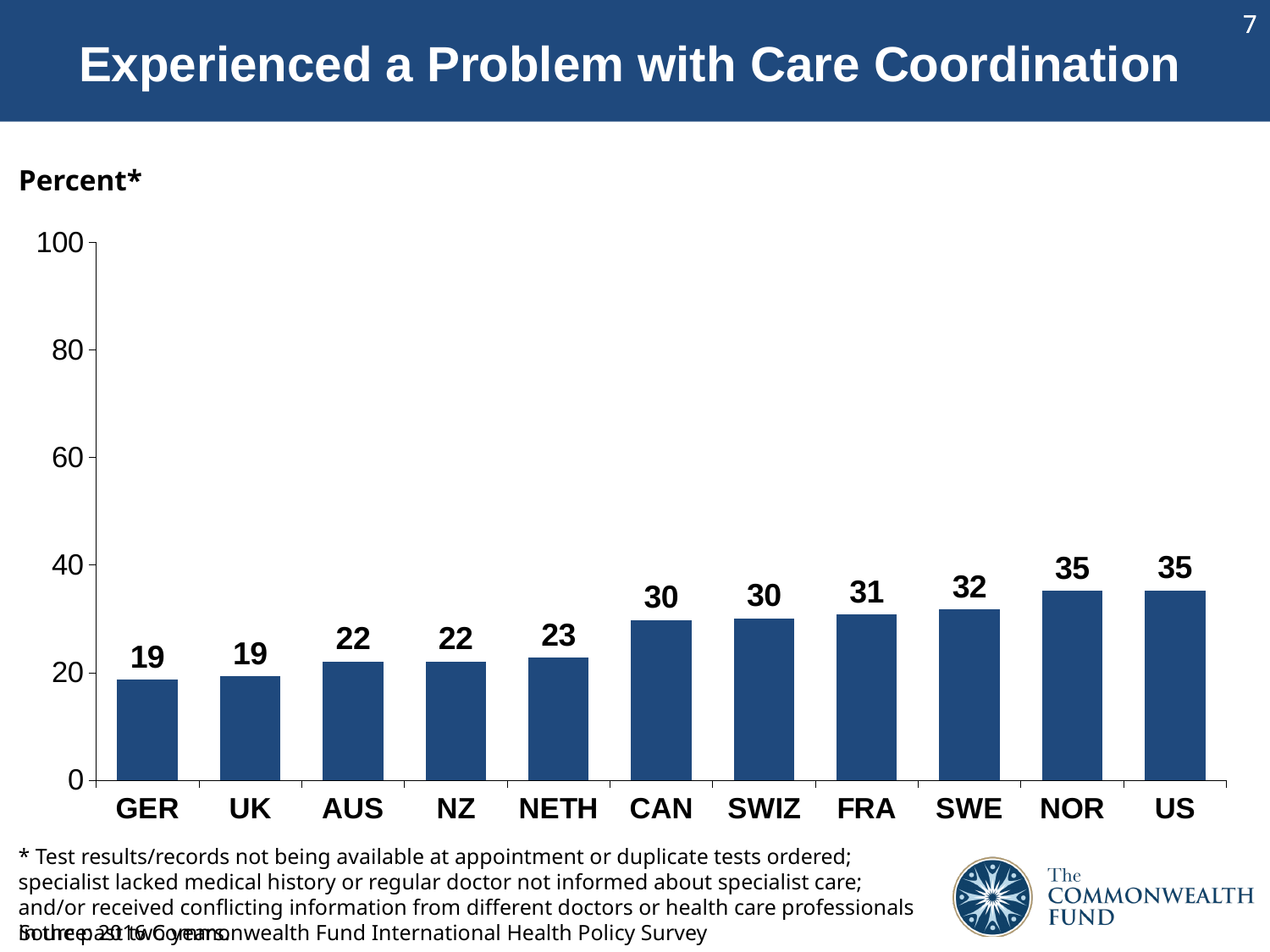
Do the values generally rise or fall from left to right along the x axis? rise What is the value for SWE? 32 Which countries have the lowest value? GER and UK What kind of chart is shown on the slide? bar chart Which countries have the highest value? NOR and US What is the value for FRA? 31 Is the value for NOR greater or less than 40? less What is the difference between the values for US and GER? 16 What is the difference between the values for SWE and AUS? 10 Which is larger, the value for CAN or the value for NZ? CAN How many countries are shown on the chart? 11 What is the value for NETH? 23